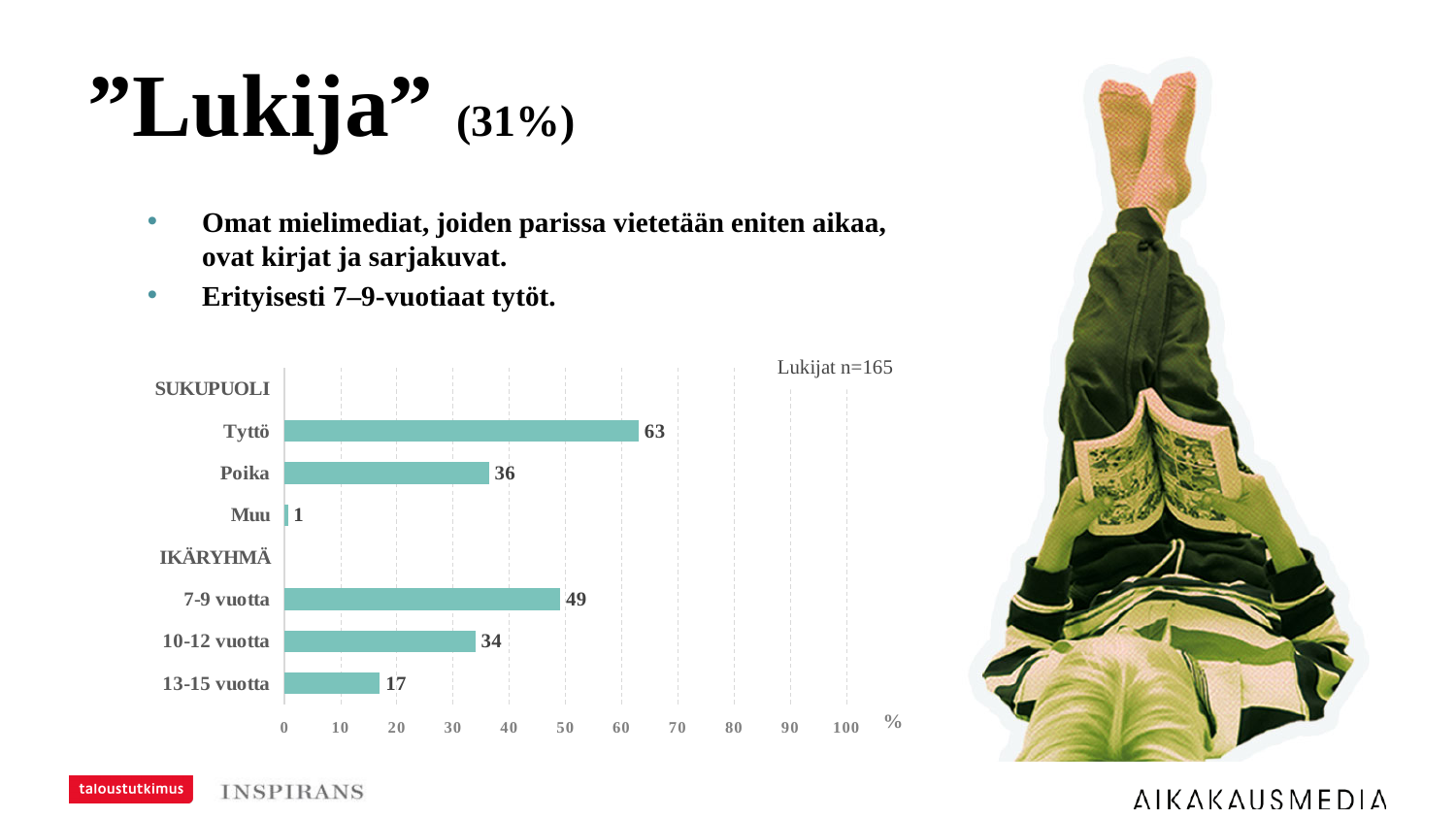
Which category has the highest value in the chart? Tyttö What is the difference between the values for Tyttö and Poika? 27 What value is shown for 10-12 vuotta? 34 What sample size (n) is stated next to the chart? Lukijat n=165 What is the difference between the values for 7-9 vuotta and 13-15 vuotta? 32 Which age group (IKÄRYHMÄ) has the lowest value? 13-15 vuotta What value is shown for Muu? 1 Is the value for 7-9 vuotta greater or less than 40? greater What type of chart is shown on the slide? bar chart Which is larger, the value for Poika or the value for 10-12 vuotta? Poika What value is shown for Tyttö? 63 How many bars with data values are plotted in the chart? 6